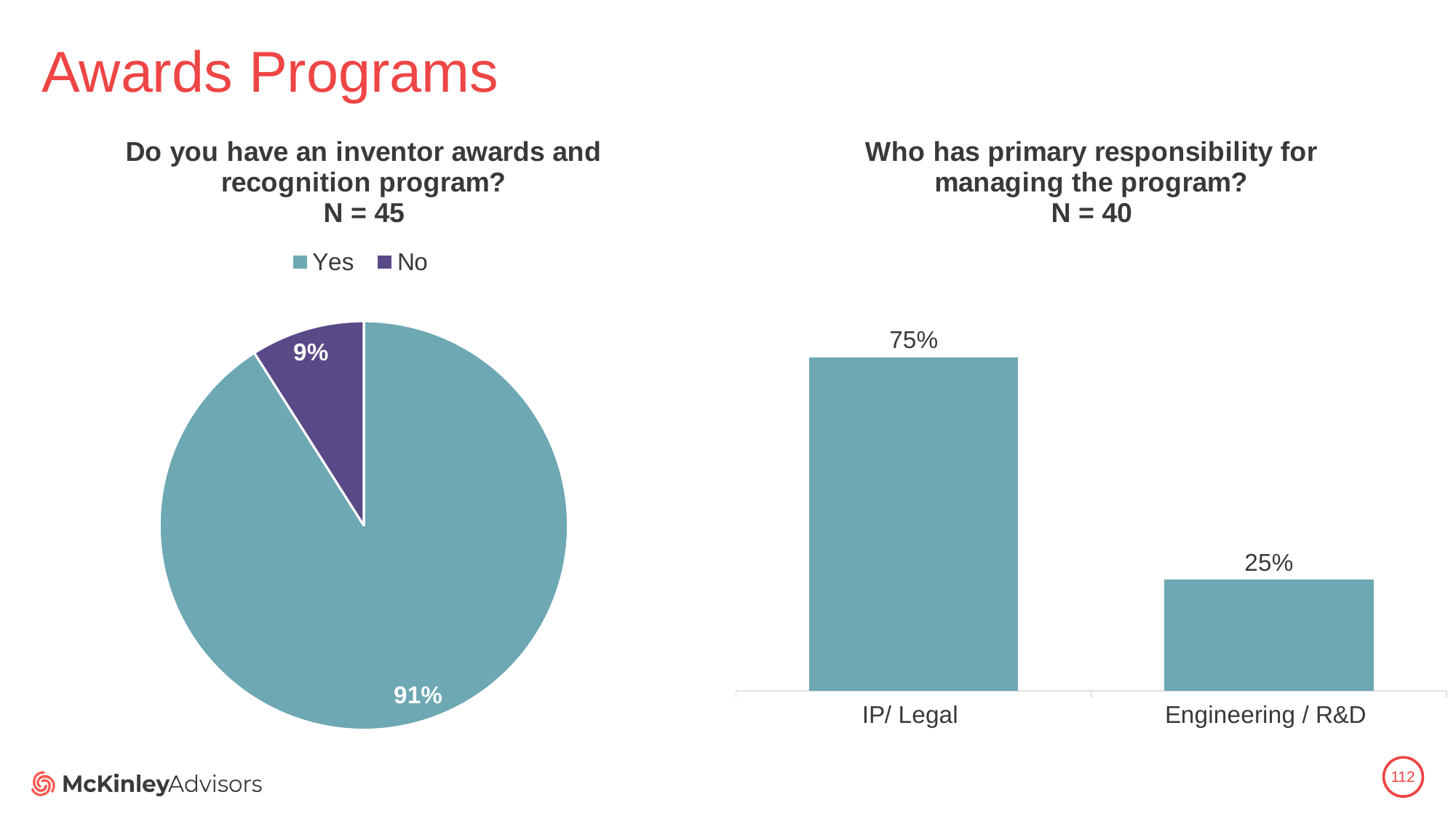
In the pie chart on the left, what percentage of respondents answered Yes? 91% What type of chart is the chart on the left? Pie chart In the pie chart on the left, what percentage of respondents answered No? 9% In the bar chart on the right, what is the difference in percentage points between IP/ Legal and Engineering / R&D? 50 In the bar chart on the right, which category has the lowest value? Engineering / R&D In the pie chart on the left, what is the difference in percentage points between Yes and No? 82 In the bar chart on the right, what is the value for Engineering / R&D? 25% How many categories are shown in the bar chart on the right? 2 In the bar chart on the right, what is the value for IP/ Legal? 75% What type of chart is the chart on the right? Bar chart In the pie chart on the left, which response has the larger share? Yes How many entries does the legend of the pie chart on the left list? 2